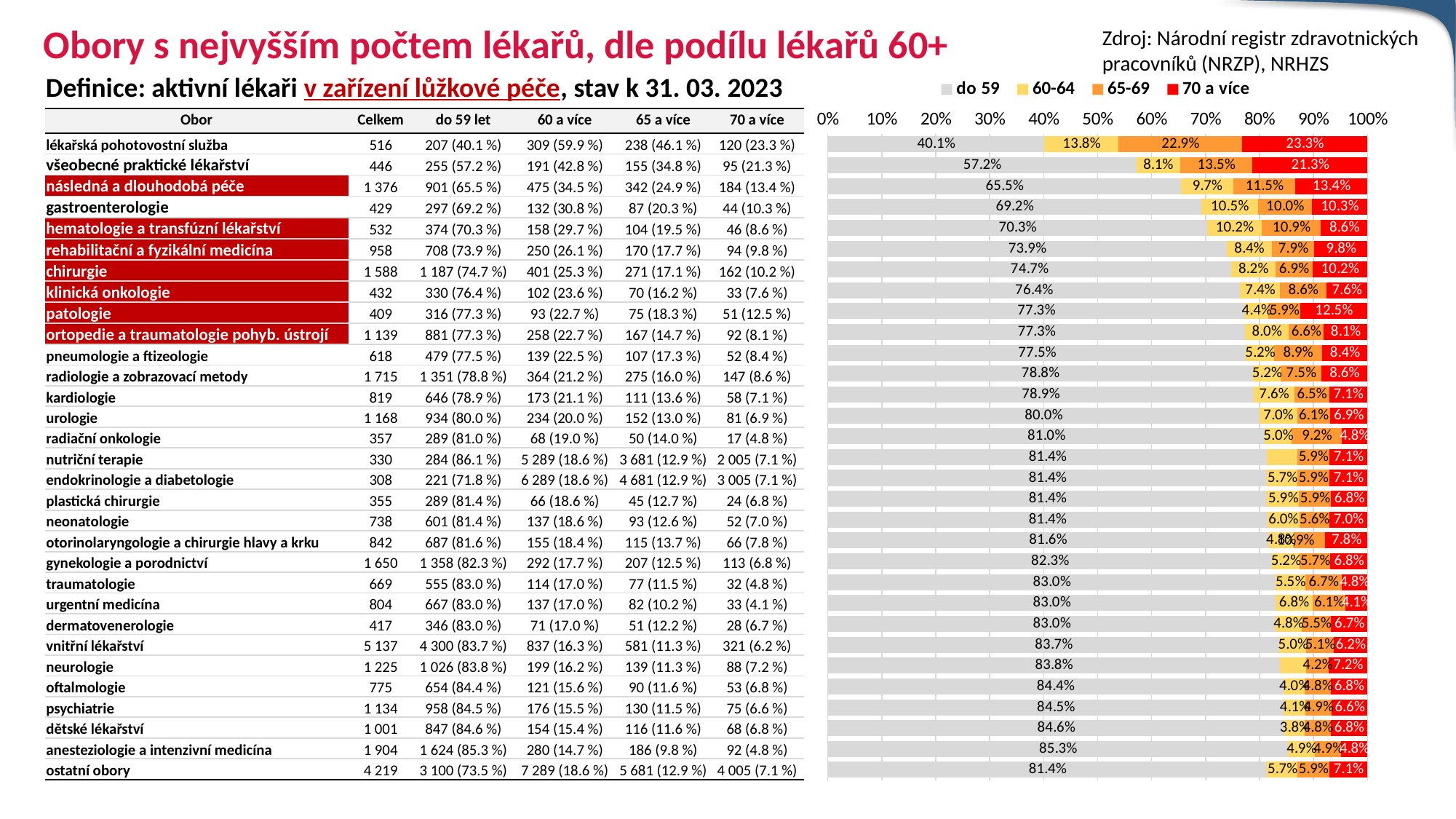
In the bar chart, which row has the smallest 'do 59' segment? lékařská pohotovostní služba (40.1%) What kind of chart is shown on the right side of the slide? stacked bar chart How many series does the legend of the bar chart list? 4 In the bar chart, is the 'do 59' share of the second bar (všeobecné praktické lékařství) greater or less than 50%? greater In the bar chart, what is the '70 a více' share shown on the top bar (lékařská pohotovostní služba)? 23.3% In the bar chart, how much larger is the '70 a více' share of the top bar (23.3%) than that of the second bar (21.3%)? 2.0 percentage points Reading the bar chart from top to bottom, do the 'do 59' shares generally rise or fall? rise In the bar chart, what is the '65-69' share shown on the second bar (všeobecné praktické lékařství)? 13.5% What colour does the legend of the bar chart use for '70 a více'? red In the top bar of the chart, which segment is larger: '60-64' or '65-69'? 65-69 In the bar chart, what is the 'do 59' share shown on the top bar (lékařská pohotovostní služba)? 40.1% In the bar chart, which row has the largest 'do 59' segment? anesteziologie a intenzivní medicína (85.3%)